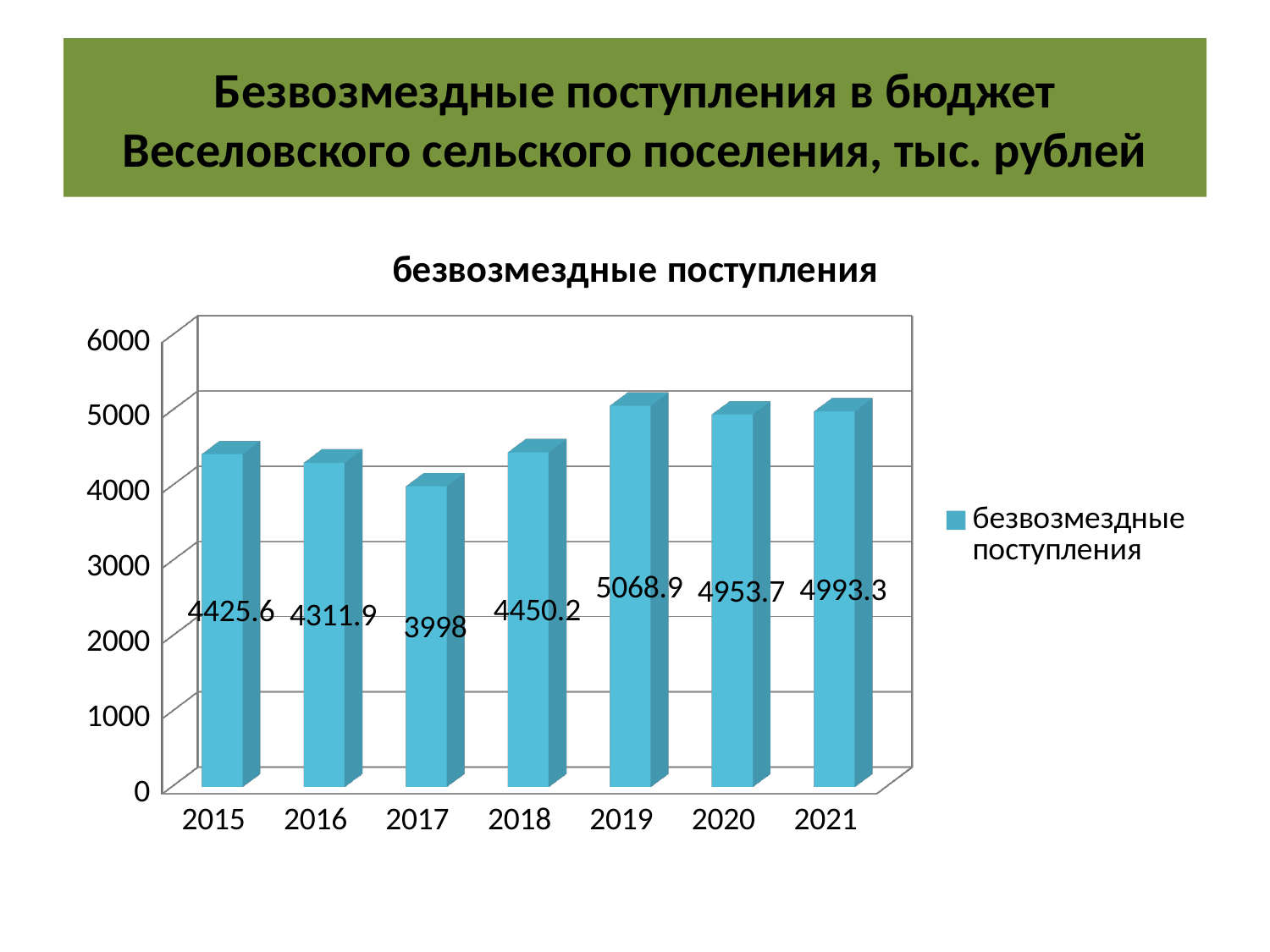
Which year has the highest value? 2019 How many series does the legend list? 1 What is the value for 2015? 4425.6 How many years are shown on the x axis? 7 Which year has the lowest value? 2017 What is the difference between the values for 2019 and 2017? 1070.9 Is the value for 2020 greater or less than 4000? greater What is the value for 2019? 5068.9 What is the title of the chart? безвозмездные поступления What is the value for 2021? 4993.3 Which is larger, the value for 2018 or the value for 2016? 2018 What kind of chart is shown? bar chart